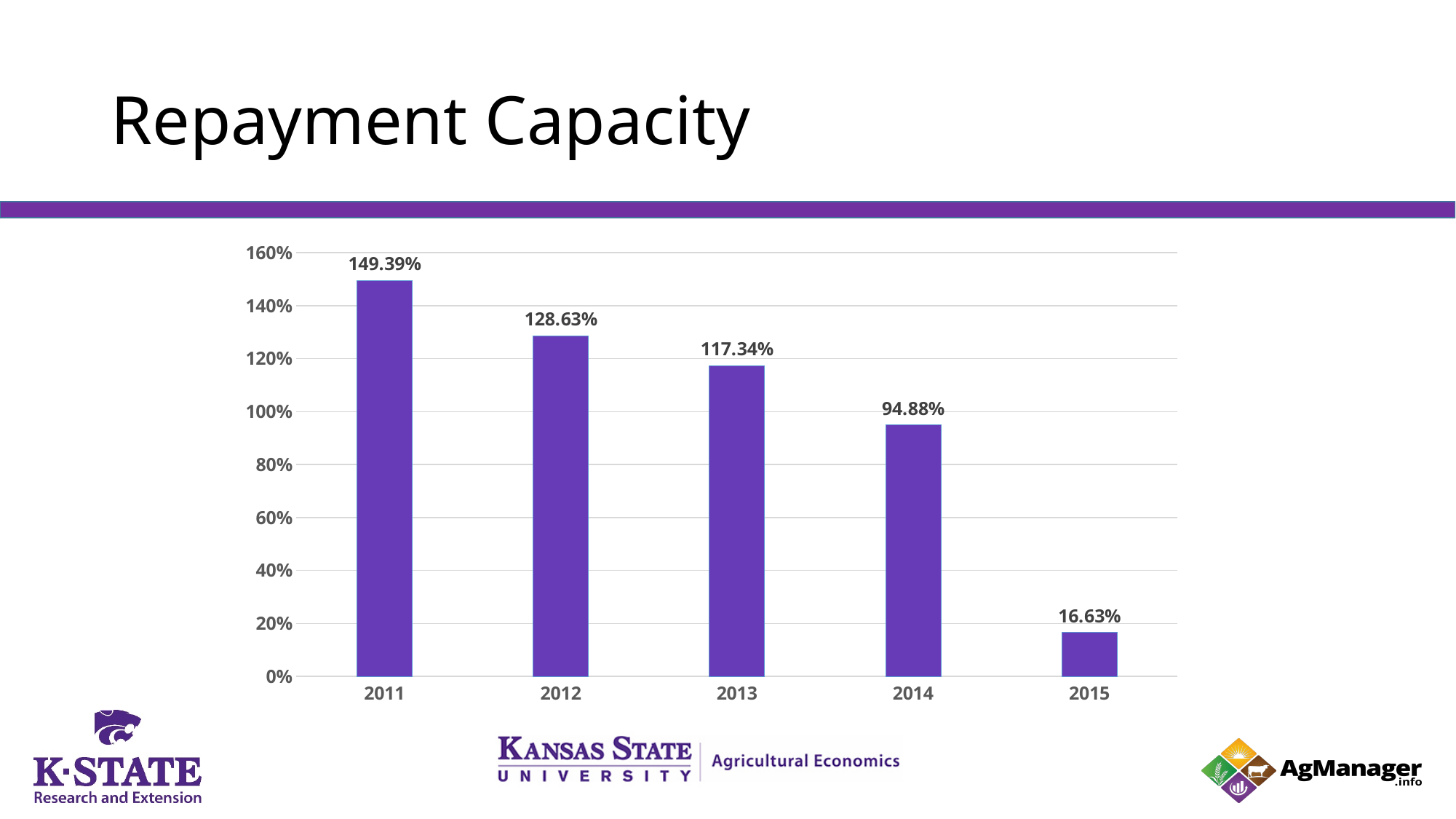
What is the repayment capacity value for 2013? 117.34% Is the value for 2014 greater or less than 100%? less How many years are shown on the chart? 5 Which year has a larger value, 2013 or 2014? 2013 What is the repayment capacity value for 2015? 16.63% What kind of chart is shown on the slide? bar chart What is the repayment capacity value for 2011? 149.39% What is the difference between the 2011 and 2012 values? 20.76% Which year has the lowest repayment capacity? 2015 Which year has the highest repayment capacity? 2011 Do the values rise or fall from 2011 to 2015? fall What is the difference between the 2014 and 2015 values? 78.25%